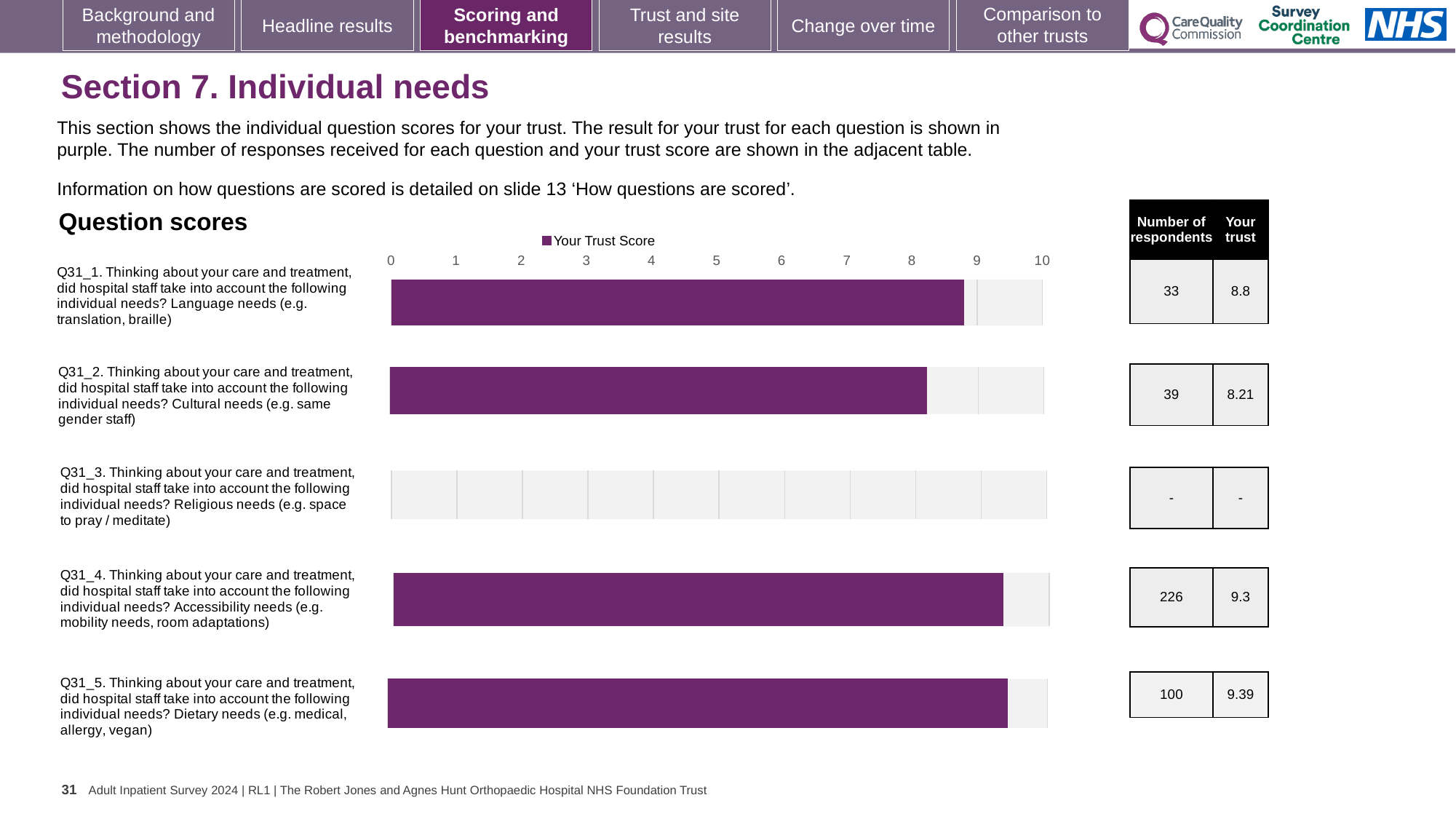
Which has the larger trust score, Q31_1 or Q31_4? Q31_4 Among the questions with a score shown, which has the lowest trust score? Q31_2 (Cultural needs) How many respondents answered Q31_4 (Accessibility needs)? 226 What type of chart is used to show the question scores? Bar chart Is the trust score for Q31_2 greater or less than 9? less Which question has the highest trust score? Q31_5 (Dietary needs) Which question has no score shown in the chart or table? Q31_3 (Religious needs) What is the trust score for Q31_5 (Dietary needs)? 9.39 What is the trust score for Q31_2 (Cultural needs)? 8.21 What is the trust score for Q31_1 (Language needs)? 8.8 How many questions are listed in the chart? 5 What is the difference between the trust scores for Q31_4 and Q31_2? 1.09